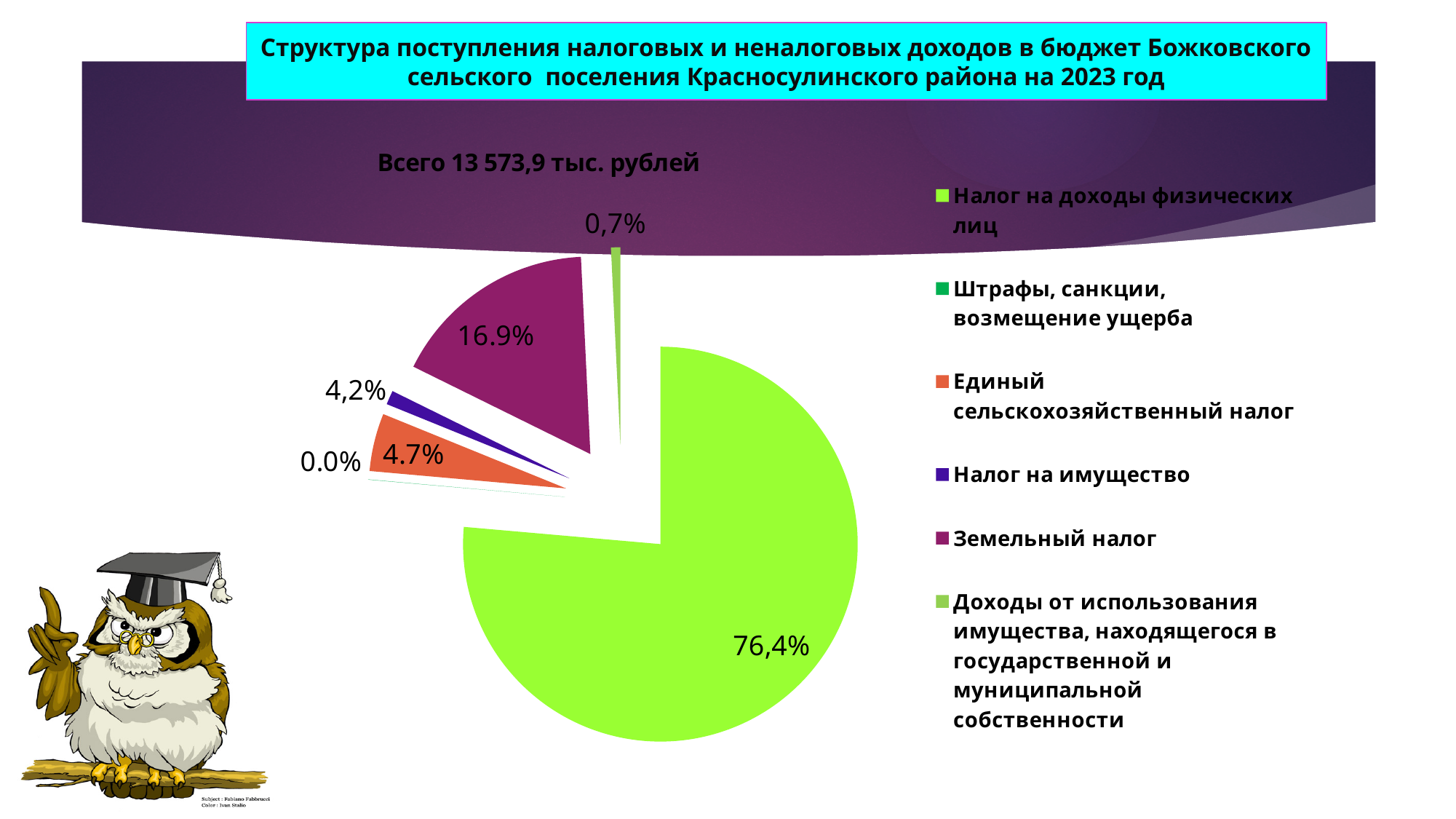
What share of the pie does "Налог на имущество" have? 4,2% How many categories does the legend of the pie chart list? 6 What kind of chart is shown on the slide? pie chart What share of the pie does "Доходы от использования имущества, находящегося в государственной и муниципальной собственности" have? 0,7% What total amount is stated above the pie chart? Всего 13 573,9 тыс. рублей What share of the pie does "Налог на доходы физических лиц" have? 76,4% What share of the pie does "Земельный налог" have? 16.9% What share of the pie does "Единый сельскохозяйственный налог" have? 4.7% What share of the pie does "Штрафы, санкции, возмещение ущерба" have? 0.0% Which is larger: the share for "Земельный налог" or the share for "Единый сельскохозяйственный налог"? Земельный налог Which category has the largest share of the pie? Налог на доходы физических лиц Which category has the smallest share of the pie? Штрафы, санкции, возмещение ущерба